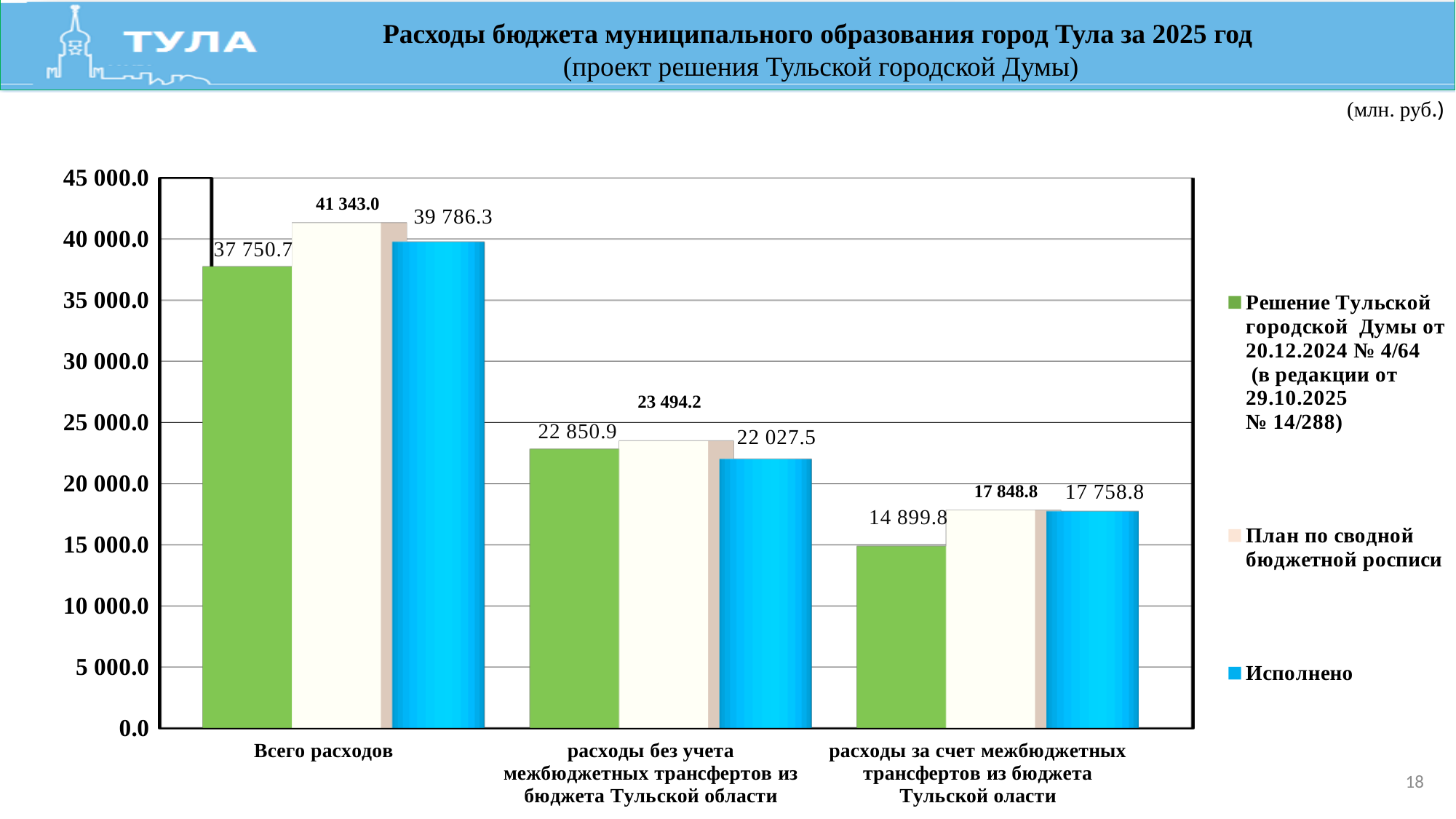
What is the value of the green series (Решение Тульской городской Думы) for "расходы за счет межбюджетных трансфертов из бюджета Тульской оласти"? 14 899.8 Which category has the highest "Исполнено" value? Всего расходов What is the difference between "План по сводной бюджетной росписи" and "Исполнено" for "Всего расходов"? 1 556.7 What is the difference between "План по сводной бюджетной росписи" and "Исполнено" for "расходы за счет межбюджетных трансфертов из бюджета Тульской оласти"? 90.0 Which category has the lowest value for "План по сводной бюджетной росписи"? расходы за счет межбюджетных трансфертов из бюджета Тульской оласти What is the value of "Исполнено" for "расходы без учета межбюджетных трансфертов из бюджета Тульской области"? 22 027.5 How many series does the legend list? 3 How many categories are shown on the x axis? 3 For "Всего расходов", which is larger: the green series (Решение Тульской городской Думы) or "Исполнено"? Исполнено What kind of chart is shown on the slide? Bar chart What is the value of "Исполнено" for "Всего расходов"? 39 786.3 What is the value of "План по сводной бюджетной росписи" for "Всего расходов"? 41 343.0